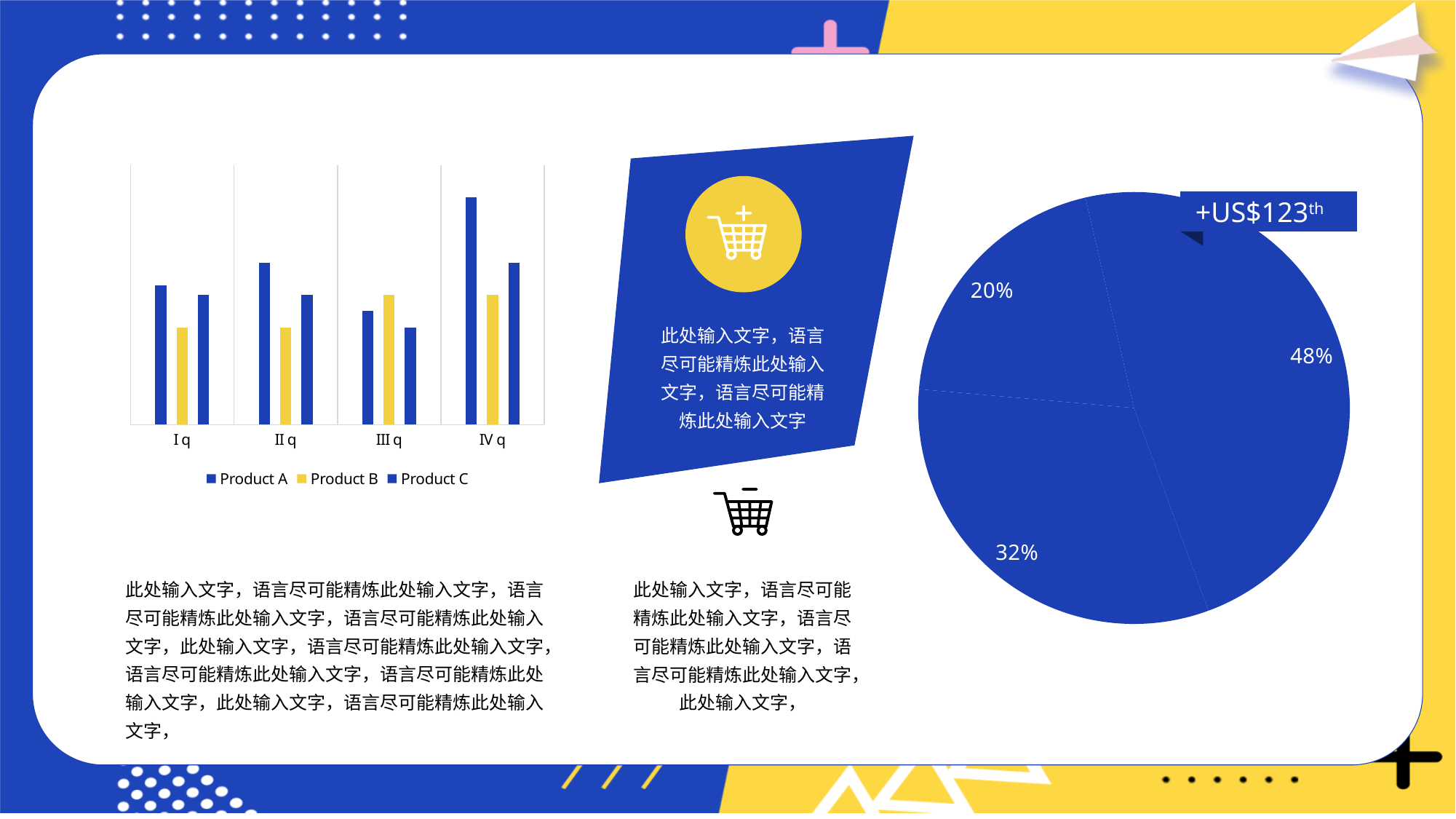
In the bar chart on the left, in which category is Product A lowest? III q In the bar chart on the left, in which category is Product A highest? IV q How many categories are shown on the x axis of the bar chart on the left? 4 How many series does the legend of the bar chart on the left list? 3 What kind of chart is the chart on the right of the slide? pie chart What is the share of the smallest slice in the pie chart on the right? 20% What is the share of the largest slice in the pie chart on the right? 48% In the bar chart on the left, which series is shown in yellow? Product B What kind of chart is the chart on the left of the slide? bar chart In the bar chart on the left, in which category is Product C lowest? III q How many slices does the pie chart on the right have? 3 In the bar chart on the left, which is larger in IV q: Product A or Product B? Product A